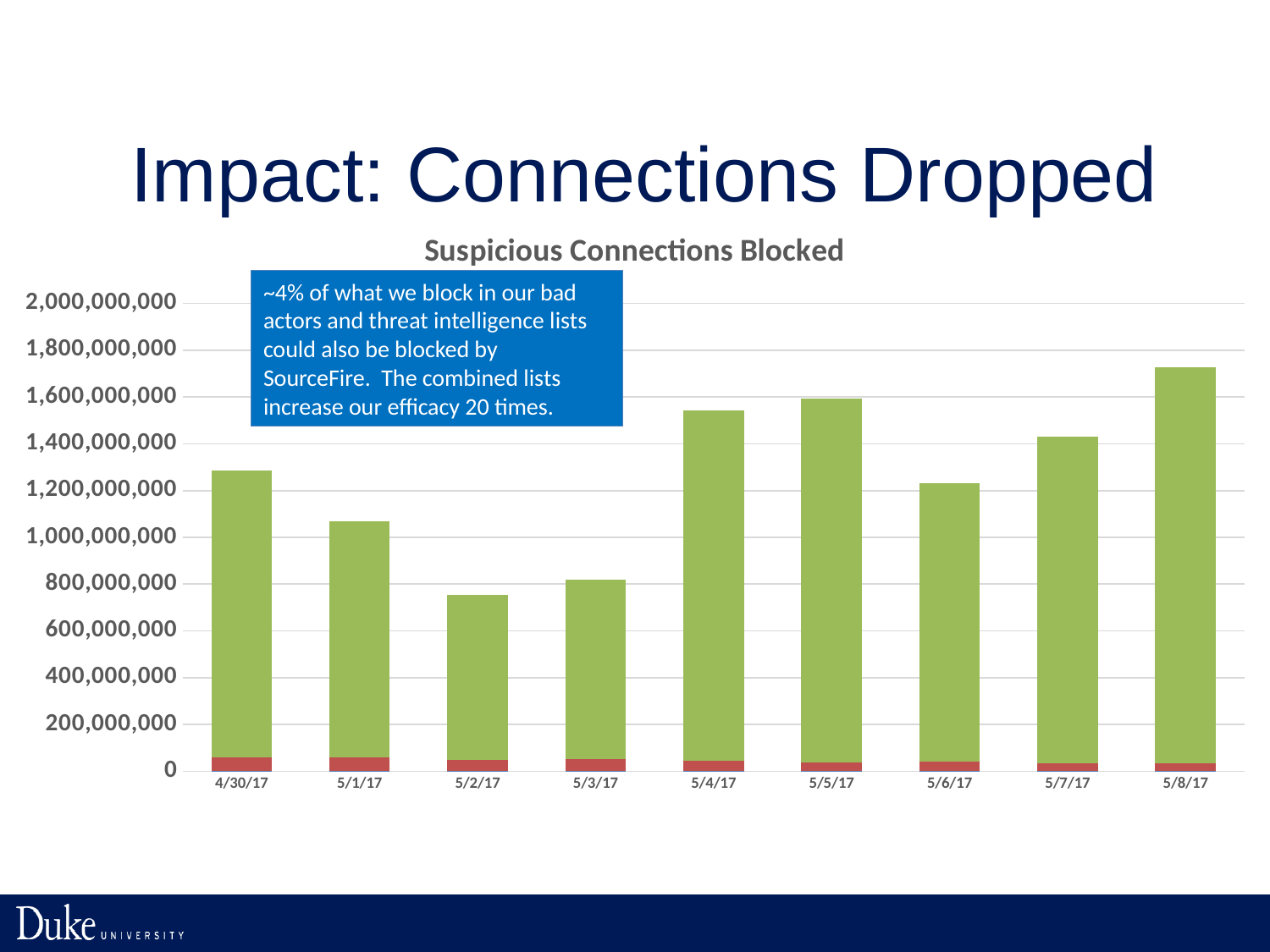
What is the title of the chart? Suspicious Connections Blocked Do the bars rise or fall from 5/1/17 to 5/2/17? fall Is the total bar for 5/2/17 greater or less than 800,000,000? less Which bar is taller, 5/4/17 or 5/1/17? 5/4/17 Is the total bar for 5/8/17 greater or less than 1,600,000,000? greater Is the total bar for 5/6/17 greater or less than 1,400,000,000? less What kind of chart is shown on the slide? Stacked bar chart Which date has the tallest bar in the chart? 5/8/17 Which date has the shortest bar in the chart? 5/2/17 How many dates are shown on the x axis of the chart? 9 Which bar is taller, 5/3/17 or 5/7/17? 5/7/17